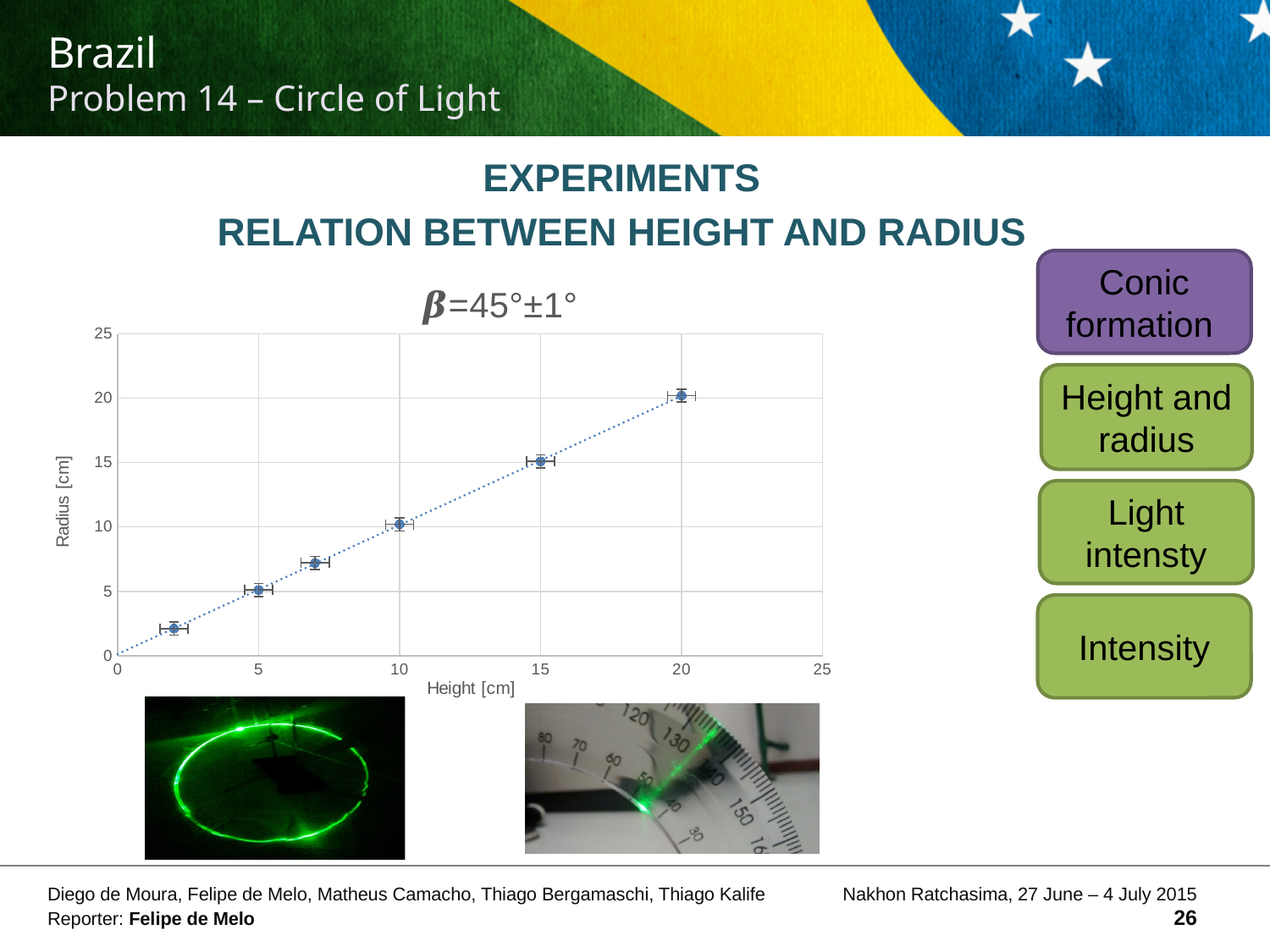
What kind of chart is shown on the slide? scatter plot Which plotted point has the largest radius: the one at a height of 10 cm or the one at a height of 20 cm? the one at 20 cm What is the label of the x axis? Height [cm] Do the radius values rise or fall as height increases along the x axis? rise Is the radius for the point at a height of 15 cm greater or less than 20? less What is the title of the chart? β=45°±1° Is the radius for the point at a height of 2 cm greater or less than 5? less At which height does the plotted point with the smallest radius occur? 2 cm At which height does the plotted point with the largest radius occur? 20 cm Is the radius for the point at a height of 7 cm greater or less than 5? greater How many data points are plotted on the chart? 6